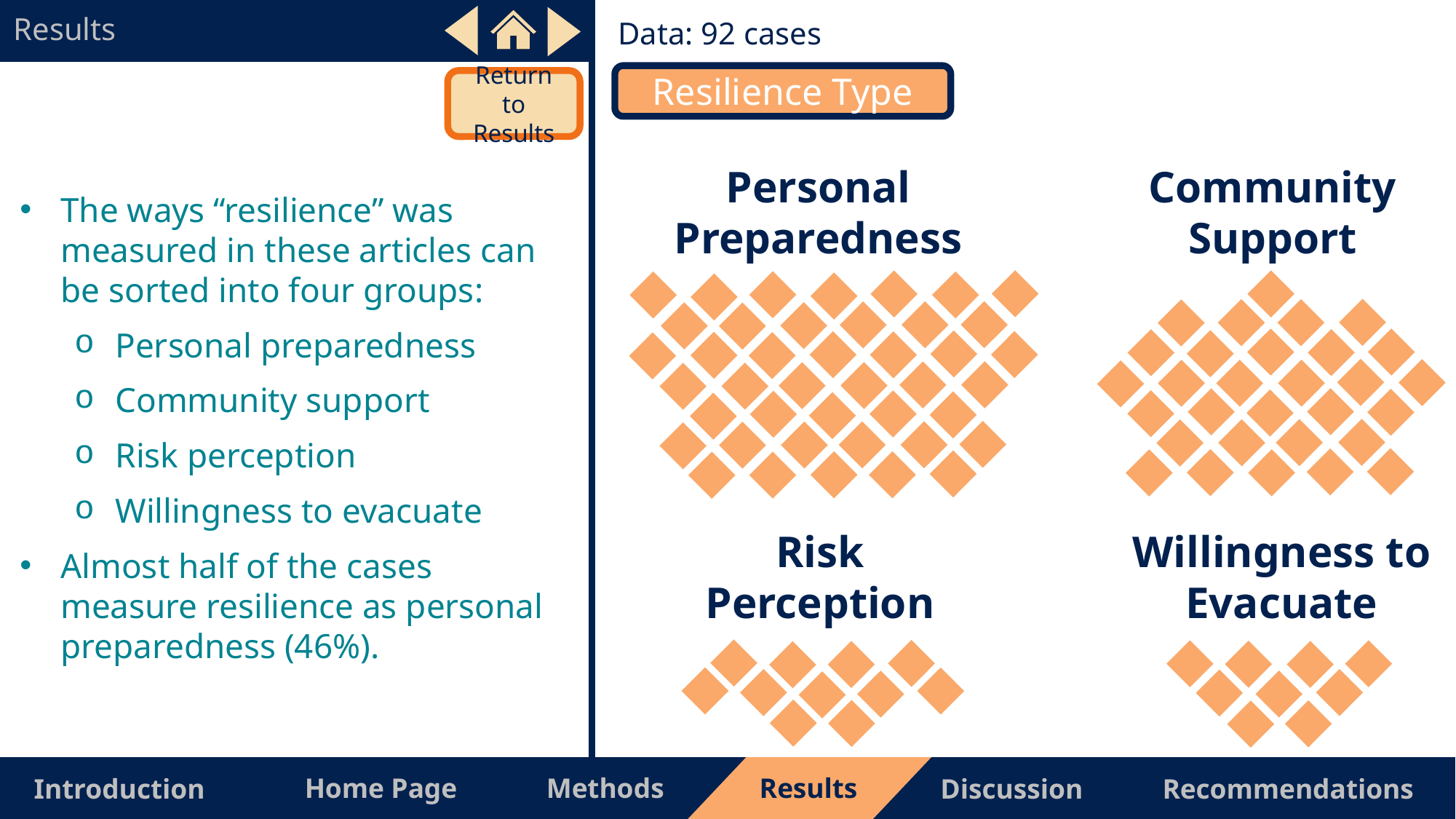
Which has more cases, Community Support or Risk Perception? Community Support What is the title shown above the chart? Resilience Type What share of the cases measure resilience as personal preparedness? 46% Which resilience type has the fewest cases? Willingness to Evacuate What shape and colour are the icons used in the chart? Orange diamonds Which has more cases, Personal Preparedness or Community Support? Personal Preparedness How many cases in total does the chart's data cover? 92 cases Which resilience type has the most cases? Personal Preparedness What kind of chart is used to show the resilience types? Pictogram (icon chart) How many resilience type categories does the chart show? 4